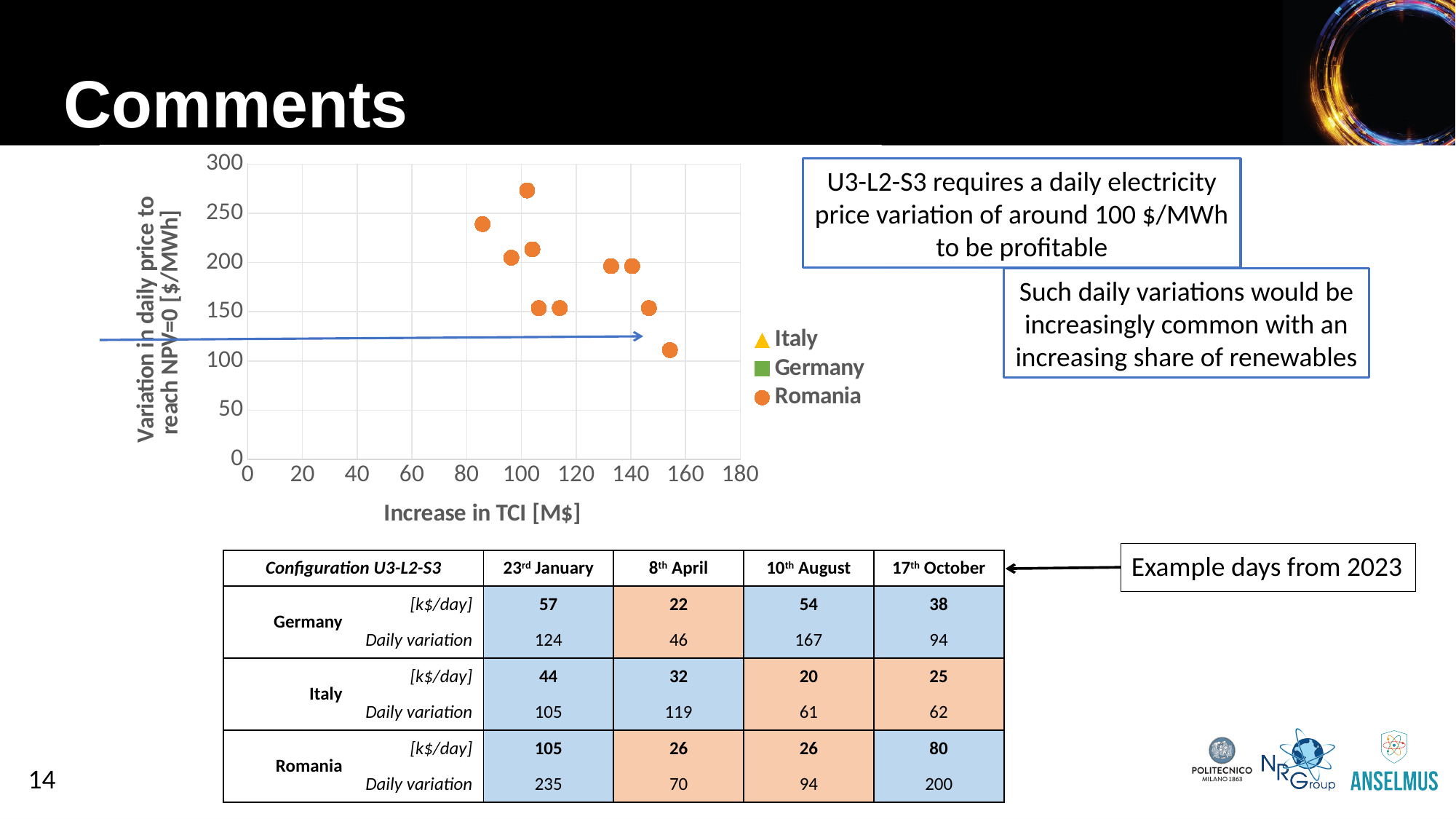
Is the lowest plotted point on the chart greater or less than 100 on the y axis? greater Is the highest plotted point on the chart greater or less than 250 on the y axis? greater How many series does the chart legend list? 3 What kind of chart is shown on the slide? scatter chart How many data points are plotted on the chart? 10 Do the plotted values on the chart generally rise or fall as the increase in TCI grows? fall Which series do the plotted points on the chart belong to? Romania Which series are listed in the chart legend? Italy, Germany, Romania Is the lowest plotted point on the chart greater or less than 150 on the y axis? less What is the title of the x axis of the chart? Increase in TCI [M$]